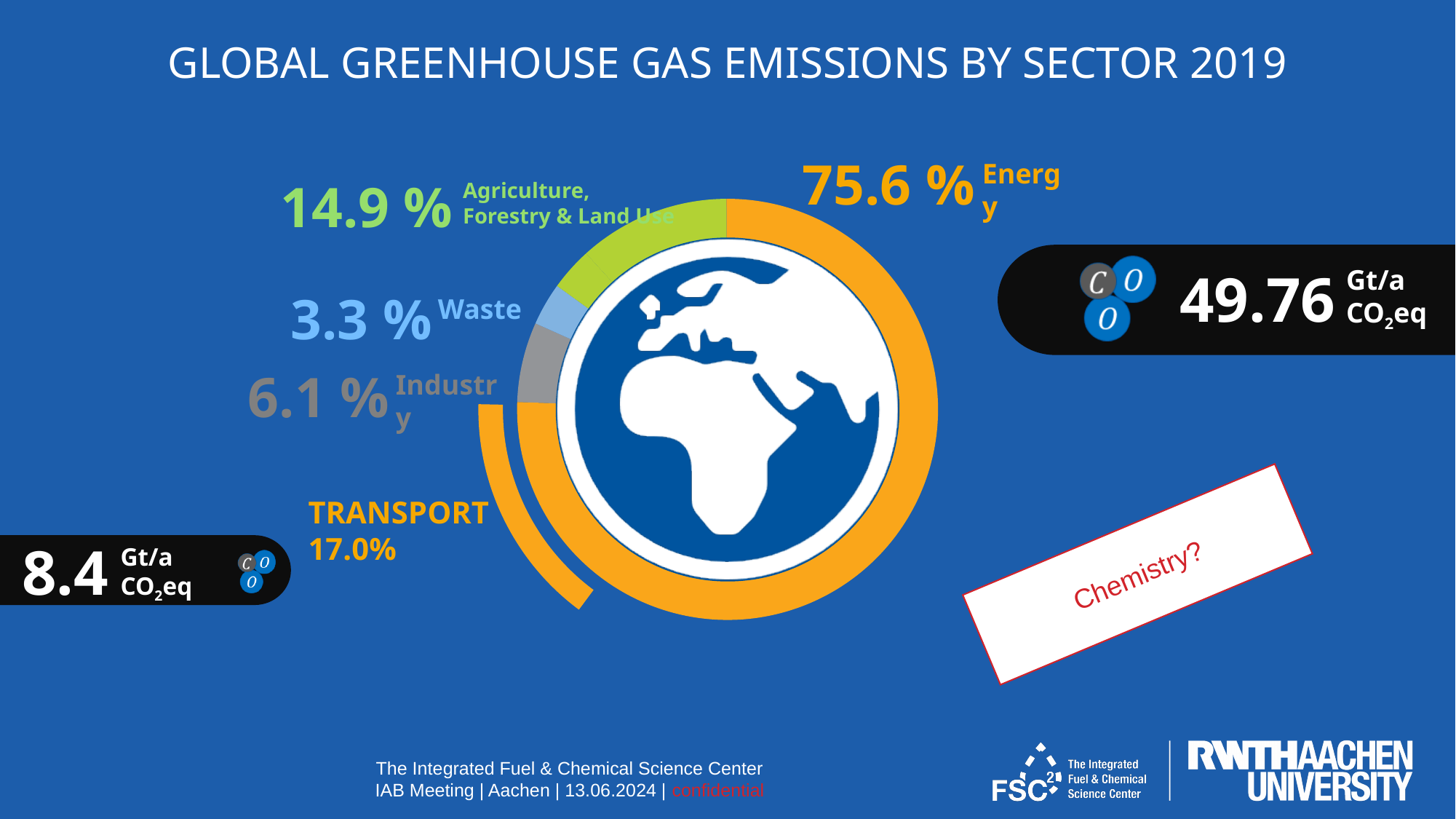
What total amount of greenhouse gas emissions is shown for 2019? 49.76 Gt/a CO2eq What amount of emissions is shown next to the Transport label? 8.4 Gt/a CO2eq What percentage share is shown for Industry? 6.1 % What percentage share is shown for Agriculture, Forestry & Land Use? 14.9 % What percentage of global greenhouse gas emissions in 2019 is attributed to Energy? 75.6 % What is the difference in percentage points between the Energy share and the Agriculture, Forestry & Land Use share? 60.7 Which has a larger share, Industry or Waste? Industry Which sector has the smallest share of emissions in the chart? Waste What kind of chart is used to show the emissions by sector? Donut (pie) chart What percentage share is shown for Waste? 3.3 % Which sector has the largest share of emissions in the chart? Energy What percentage is shown for Transport? 17.0%